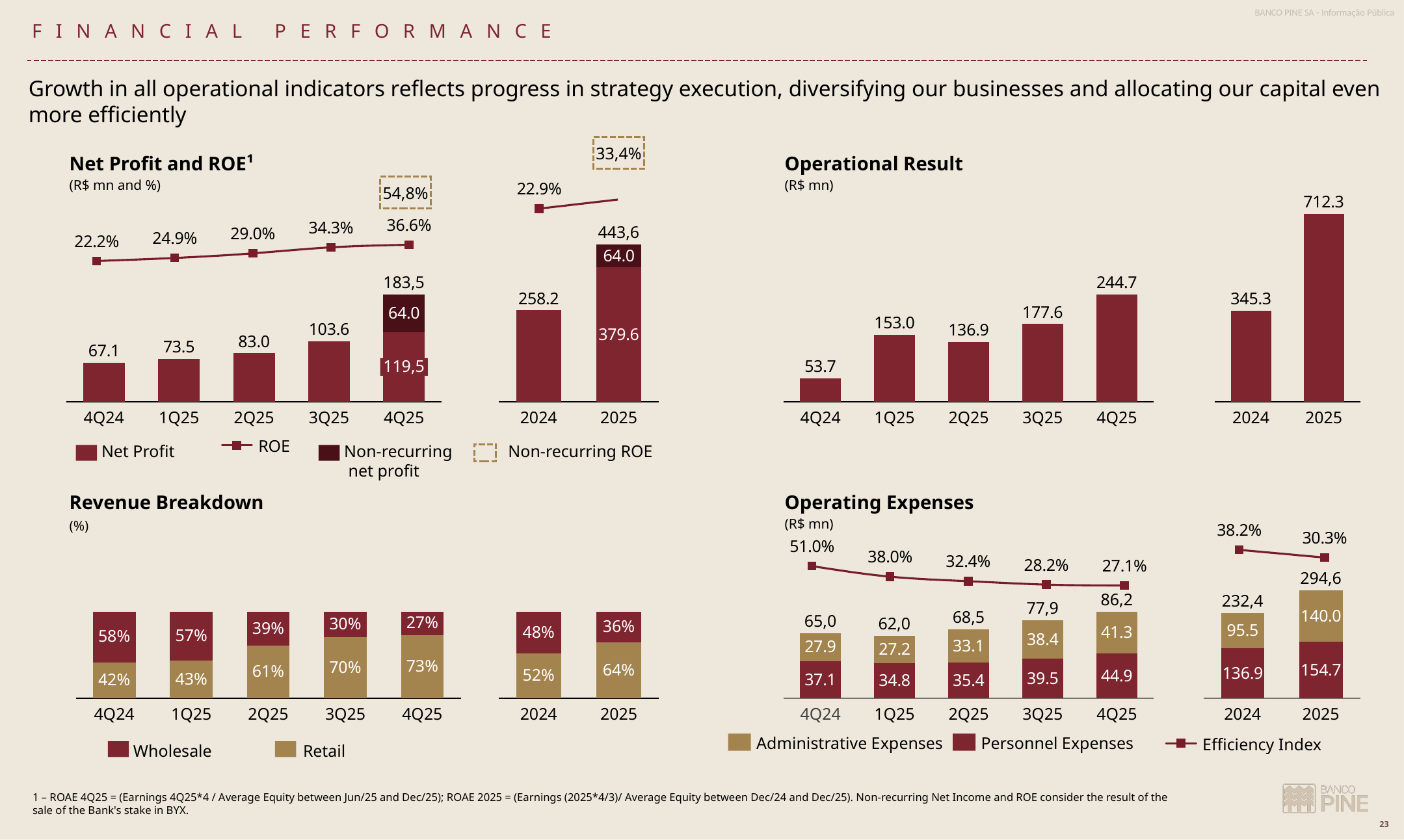
In the Operating Expenses chart, what is the Efficiency Index for 2025? 30.3% In the Net Profit and ROE chart, what is the total of the stacked bar for 2025? 443,6 In the Net Profit and ROE chart, what is the Net Profit for 3Q25? 103.6 In the Revenue Breakdown chart, what is the Retail share for 3Q25? 70% How many series does the legend of the Operating Expenses chart list? 3 In the Operational Result chart, which quarter has the lowest value? 4Q24 In the Operating Expenses chart, what are the Personnel Expenses for 4Q25? 44.9 In the Net Profit and ROE chart, what is the ROE for 2Q25? 29.0% In the Operational Result chart, which quarter has the highest value? 4Q25 In the Revenue Breakdown chart, does the Wholesale share rise or fall from 4Q24 to 4Q25? fall In the Operational Result chart, what is the difference between 2025 and 2024? 367.0 In the Operating Expenses chart, which is larger in 2024: Administrative Expenses or Personnel Expenses? Personnel Expenses